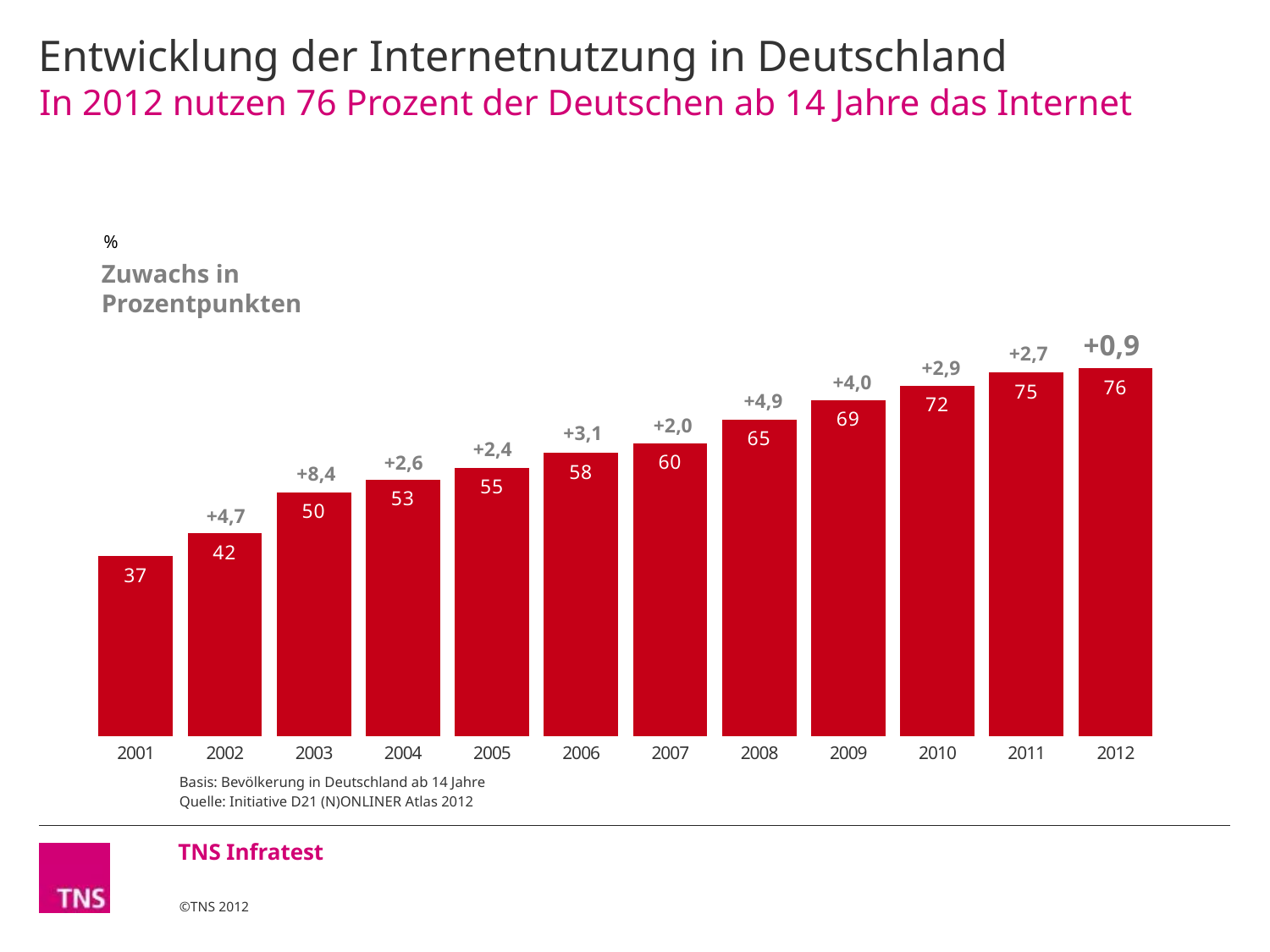
What is the value for 2008? 65 Do the values rise or fall from 2001 to 2012? rise How many years are shown on the x axis? 12 Which is larger, the value for 2005 or the value for 2007? 2007 What kind of chart is this? bar chart What is the value for 2012? 76 What growth in percentage points is shown above the bar for 2003? +8,4 Which year has the highest value? 2012 What is the difference between the values for 2012 and 2001? 39 What is the value for 2001? 37 Which year has the lowest value? 2001 What growth in percentage points is shown above the bar for 2012? +0,9